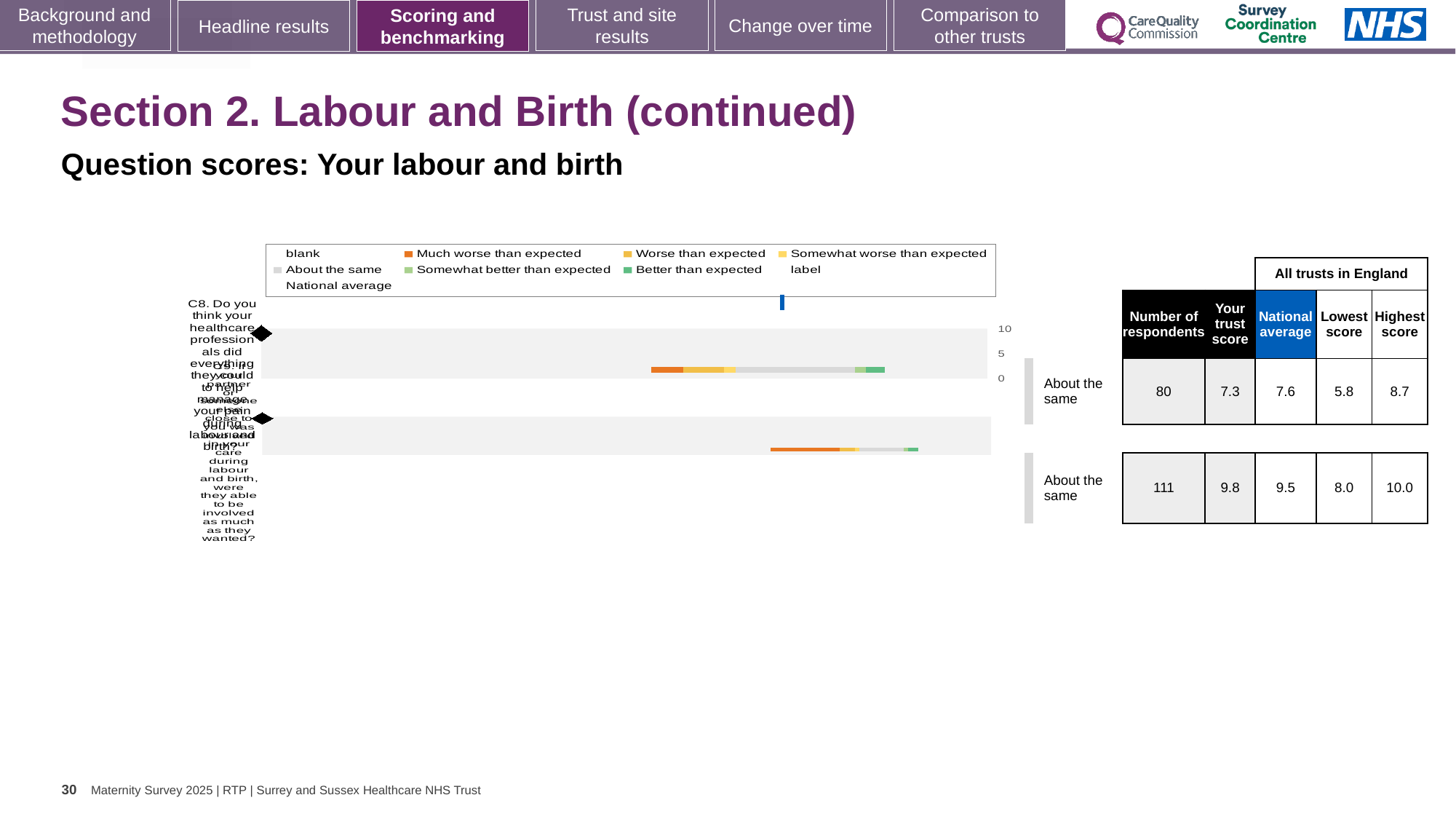
What kind of chart is shown on the slide? Bar chart For question C8 (the first row), which is larger: the trust score or the national average? National average What benchmark category is shown for both rows of the chart? About the same Which colour does the legend use for 'Much worse than expected'? Orange What is the national average for question C8 (the first row) in the table beside the chart? 7.6 What is the lowest score across all trusts in England for the second row of the chart? 8.0 How many survey questions (rows) are plotted in the chart? 2 For question C8 (the first row), what is the difference between the highest score and the lowest score across all trusts in England? 2.9 What is the trust score for question C8 (the first row) in the table beside the chart? 7.3 Which row of the chart has more respondents, the first or the second? The second What is the highest score across all trusts in England for the second row of the chart? 10.0 In the table beside the chart, how many respondents are recorded for question C8 (the first row)? 80